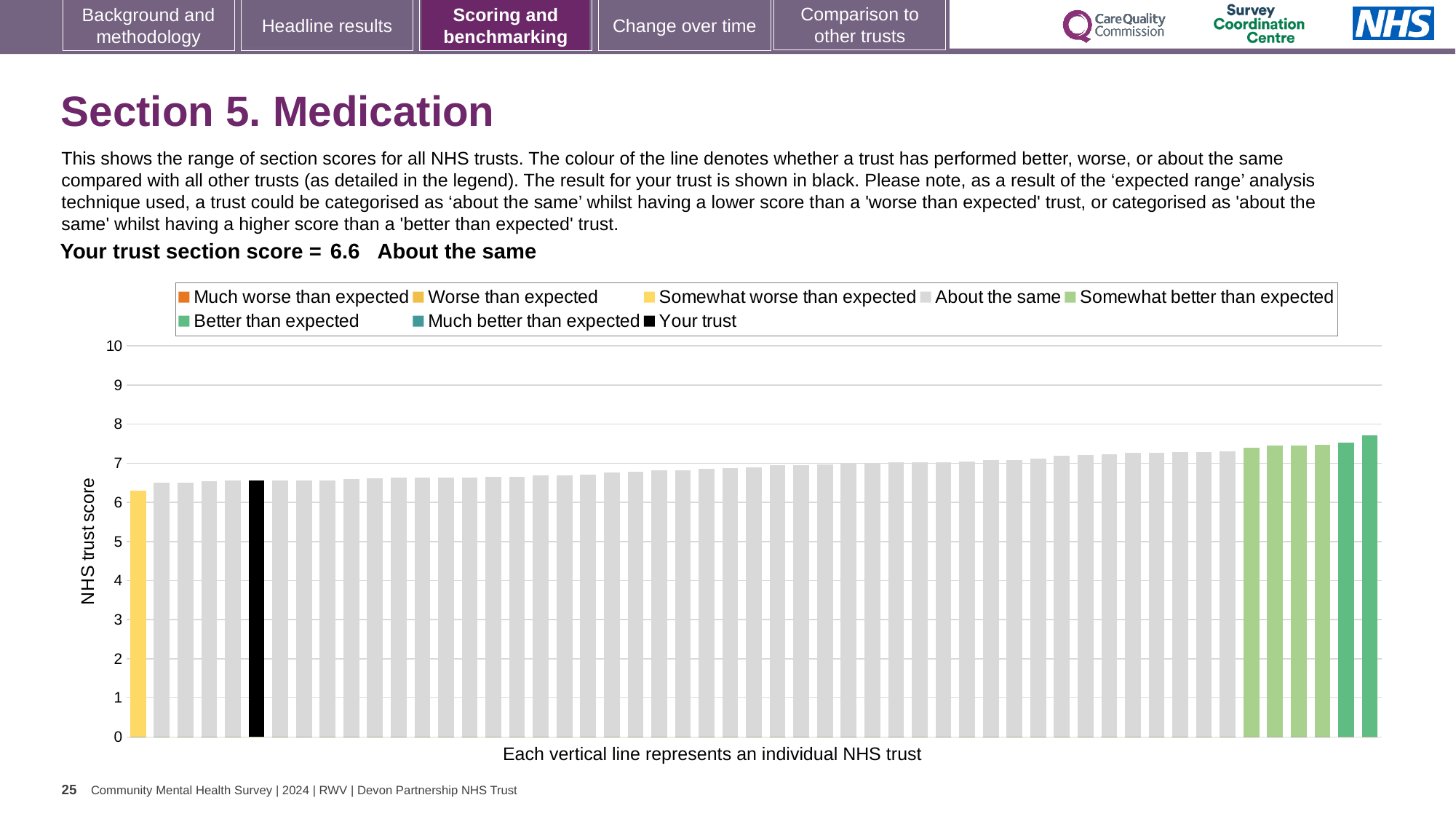
What is the trust's section score for Section 5. Medication? 6.6 How many bars are coloured as 'Somewhat better than expected'? 4 Is the value of the tallest bar greater or less than 7? greater Is the value of the black 'Your trust' bar greater or less than 7? less How many entries does the chart legend list? 8 Do the bar values rise or fall from left to right across the chart? rise Is the value of the shortest bar greater or less than 6? greater What kind of chart is shown on the slide? bar chart How many bars are coloured as 'Somewhat worse than expected'? 1 What is the label on the vertical axis of the chart? NHS trust score What colour is the bar representing your trust? black Which performance category is the trust's section score placed in? About the same